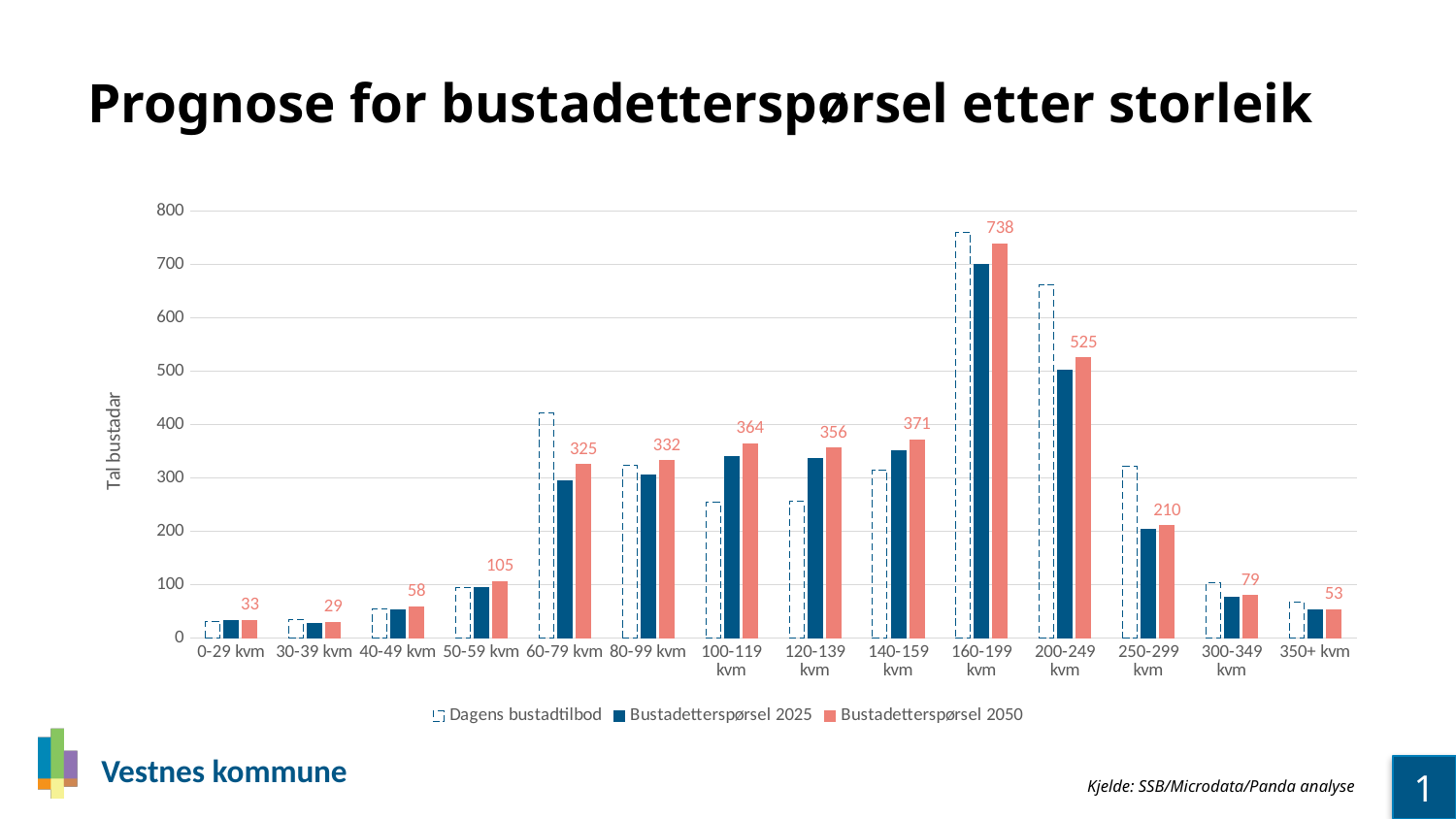
What is the value for Bustadetterspørsel 2050 in the 160-199 kvm category? 738 What is the difference between the Bustadetterspørsel 2050 values for 160-199 kvm and 200-249 kvm? 213 Which category has the lowest Bustadetterspørsel 2050 value? 30-39 kvm Is the Dagens bustadtilbod value for 60-79 kvm greater or less than 400? greater How many size categories are shown on the x axis? 14 How many series does the legend list? 3 What is the value for Bustadetterspørsel 2050 in the 250-299 kvm category? 210 What is the value for Bustadetterspørsel 2050 in the 50-59 kvm category? 105 Is the Bustadetterspørsel 2025 value for 200-249 kvm greater or less than 600? less Which is larger: the Bustadetterspørsel 2050 value for 100-119 kvm or for 120-139 kvm? 100-119 kvm Which category has the highest Bustadetterspørsel 2050 value? 160-199 kvm What type of chart is shown on the slide? Bar chart